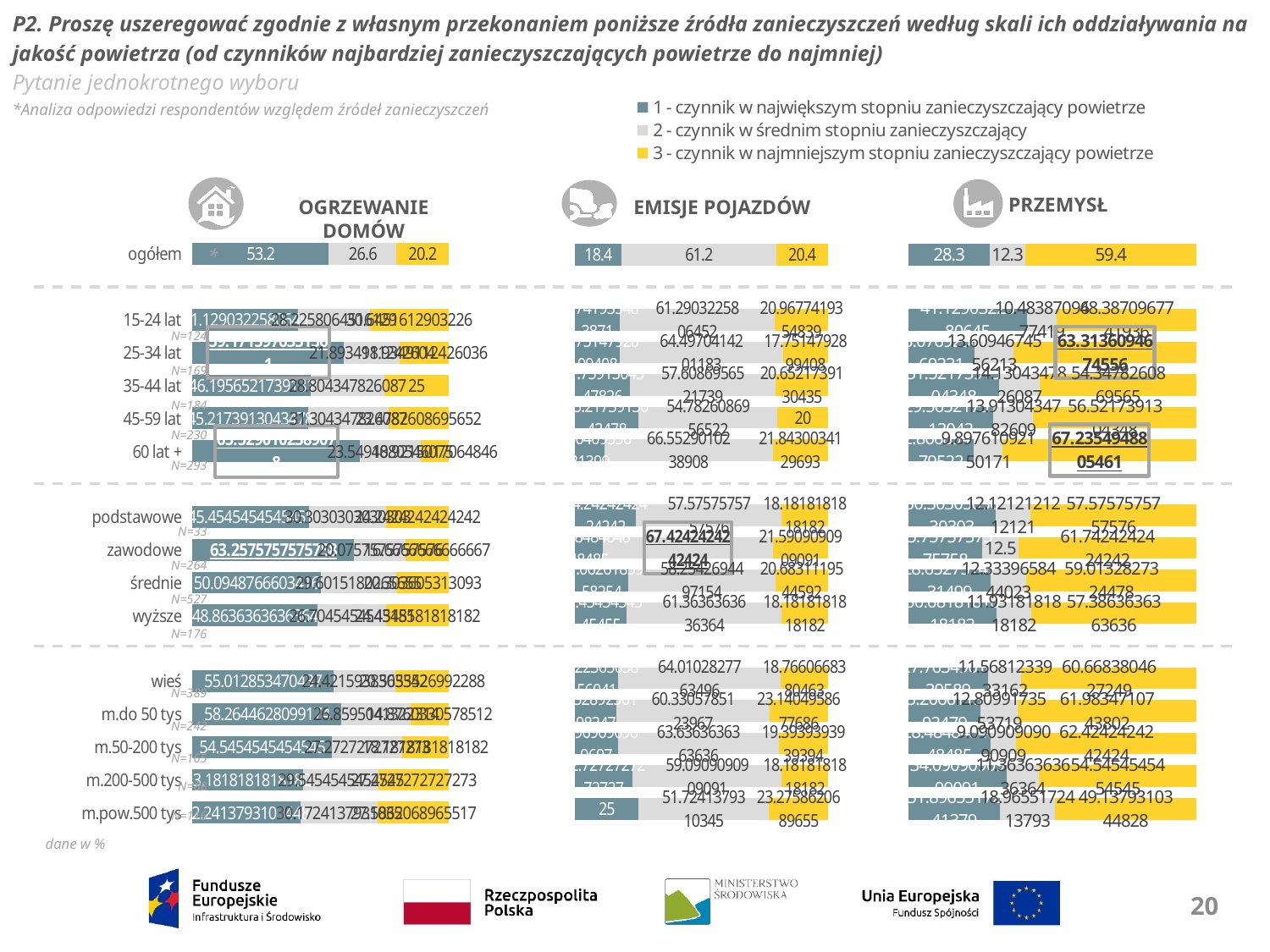
For 'ogółem', is the series 1 value larger in the OGRZEWANIE DOMÓW chart or in the PRZEMYSŁ chart? OGRZEWANIE DOMÓW In the OGRZEWANIE DOMÓW chart, what is the total of the 'ogółem' stacked bar? 100 In the PRZEMYSŁ chart, which series has the lowest value for 'ogółem'? 2 - czynnik w średnim stopniu zanieczyszczający In the PRZEMYSŁ chart, what is the value for 'ogółem' in series 1 (czynnik w największym stopniu zanieczyszczający powietrze)? 28.3 In the OGRZEWANIE DOMÓW chart, which series has the highest value for 'ogółem'? 1 - czynnik w największym stopniu zanieczyszczający powietrze How many series does the legend list? 3 What kind of chart is used for the EMISJE POJAZDÓW data? Stacked bar chart In the EMISJE POJAZDÓW chart, what is the difference between the 'ogółem' values for series 2 and series 1? 42.8 In the PRZEMYSŁ chart, what is the value for 'ogółem' in series 3 (czynnik w najmniejszym stopniu zanieczyszczający powietrze)? 59.4 In the OGRZEWANIE DOMÓW chart, what is the value for 'ogółem' in series 1 (czynnik w największym stopniu zanieczyszczający powietrze)? 53.2 In the EMISJE POJAZDÓW chart, what is the value for 'ogółem' in series 2 (czynnik w średnim stopniu zanieczyszczający)? 61.2 In the OGRZEWANIE DOMÓW chart, what is the value for 'ogółem' in series 3 (czynnik w najmniejszym stopniu zanieczyszczający powietrze)? 20.2